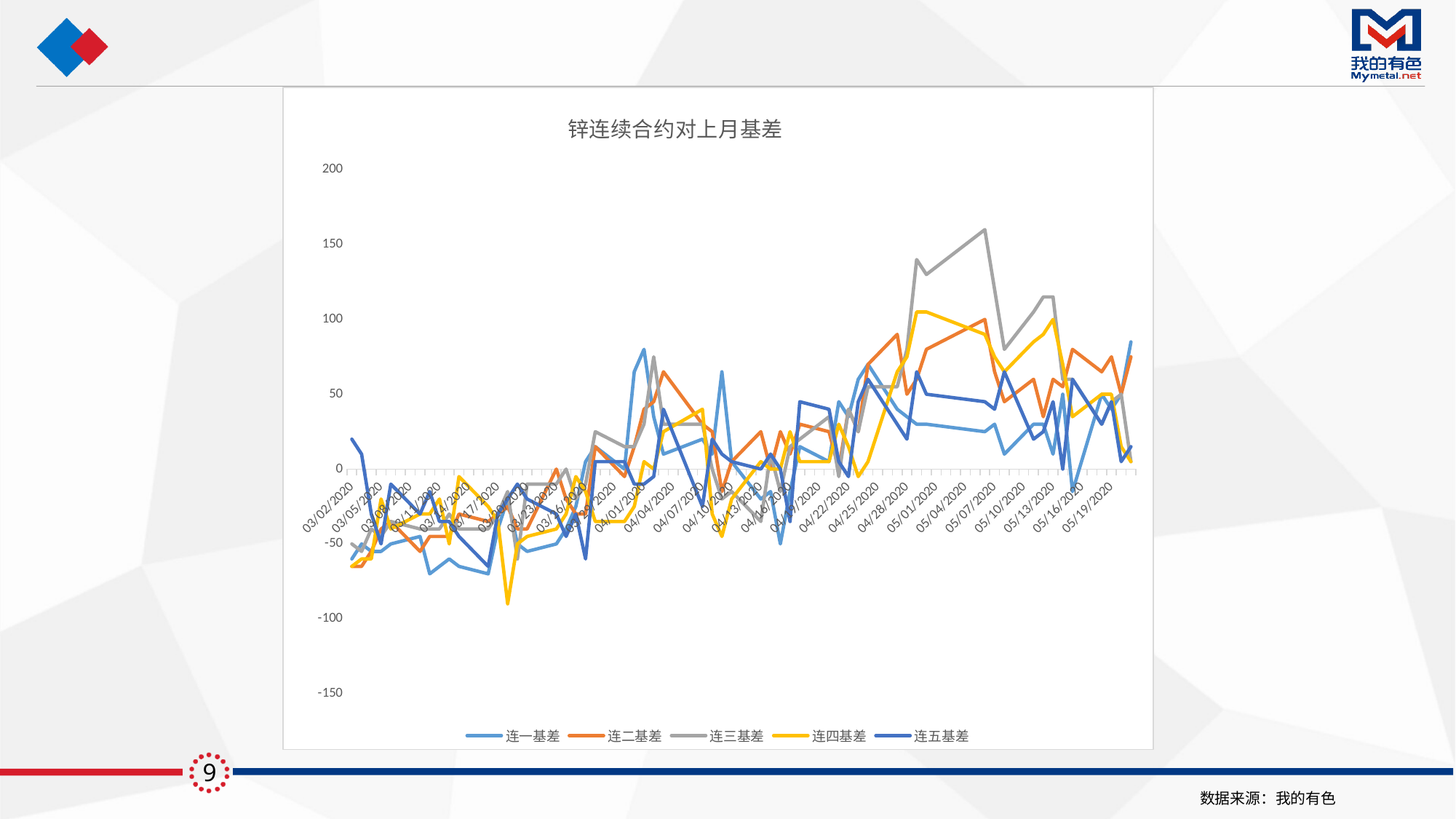
How many series does the legend list? 5 Which series reaches the highest value anywhere on the chart? 连三基差 What is the last date label on the horizontal axis? 05/19/2020 What is the highest tick shown on the vertical axis? 200 Is the peak value of 连三基差 in early May greater or less than 100? greater Which series reaches the lowest value anywhere on the chart? 连四基差 Is the lowest value of 连四基差 in March greater or less than -50? less Around 04/28/2020, is the value of 连三基差 greater or less than 连一基差? greater Overall, do the basis values rise or fall from early March to May? rise What kind of chart is shown on the slide? line chart What is the first date label on the horizontal axis? 03/02/2020 What is the title of the chart? 锌连续合约对上月基差